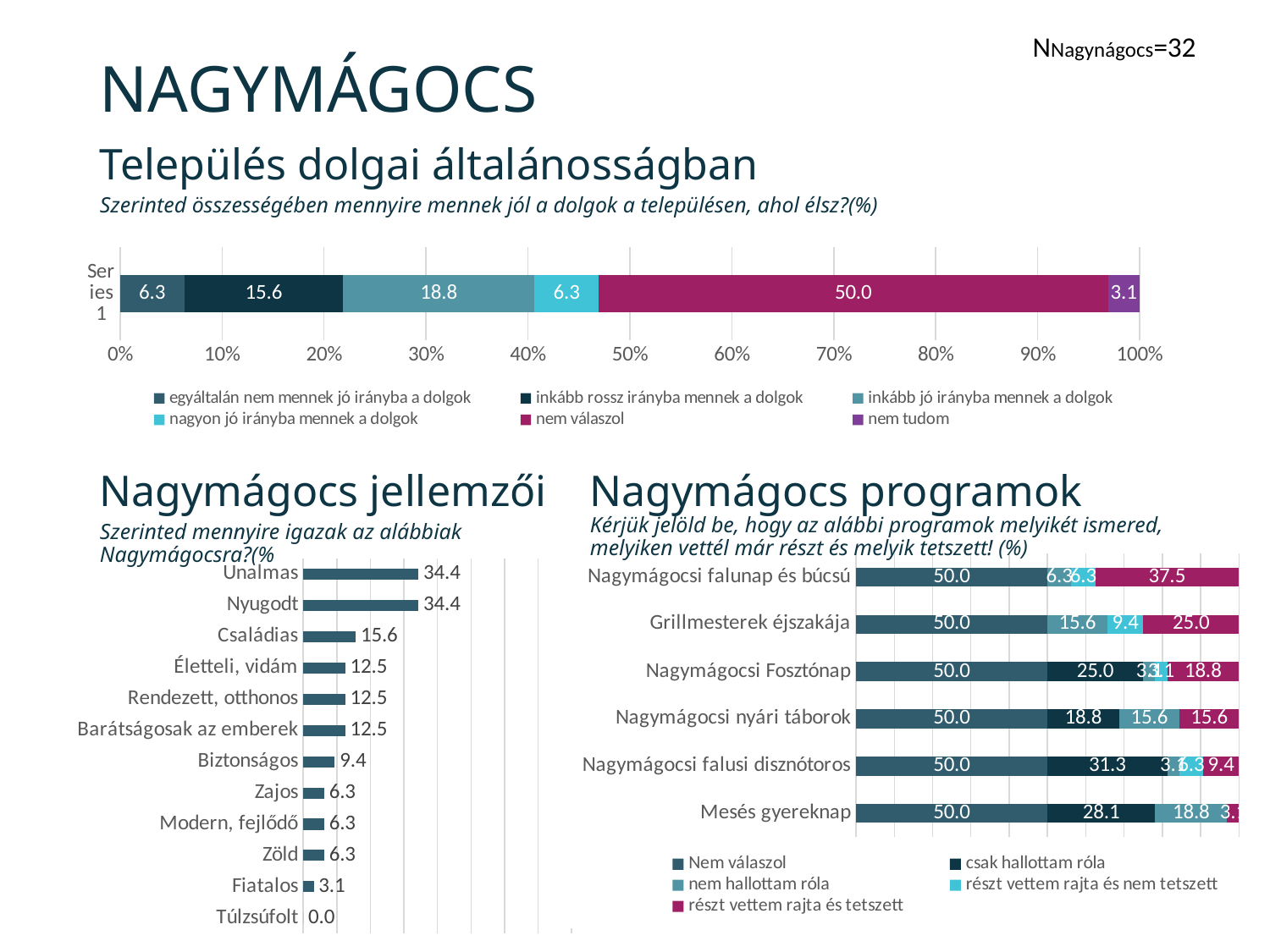
In the 'Nagymágocs programok' chart, what is the 'csak hallottam róla' value for 'Nagymágocsi falusi disznótoros'? 31.3 In the 'Nagymágocs jellemzői' chart, which category has the lowest value? Túlzsúfolt How many entries does the legend of the 'Település dolgai általánosságban' chart list? 6 In the 'Nagymágocs programok' chart, what is the 'részt vettem rajta és tetszett' value for 'Nagymágocsi falunap és búcsú'? 37.5 In the 'Nagymágocs jellemzői' chart, which is larger: 'Biztonságos' or 'Fiatalos'? Biztonságos How many categories are shown in the 'Nagymágocs jellemzői' chart? 12 In the 'Település dolgai általánosságban' chart, what is the value for 'inkább jó irányba mennek a dolgok'? 18.8 How many series does the legend of the 'Nagymágocs programok' chart list? 5 In the 'Nagymágocs jellemzői' chart, what is the value for 'Családias'? 15.6 In the 'Település dolgai általánosságban' chart, what is the difference between 'inkább rossz irányba mennek a dolgok' and 'egyáltalán nem mennek jó irányba a dolgok'? 9.3 What kind of chart is 'Nagymágocs jellemzői'? bar chart In the 'Település dolgai általánosságban' chart, what is the value for 'nem válaszol'? 50.0